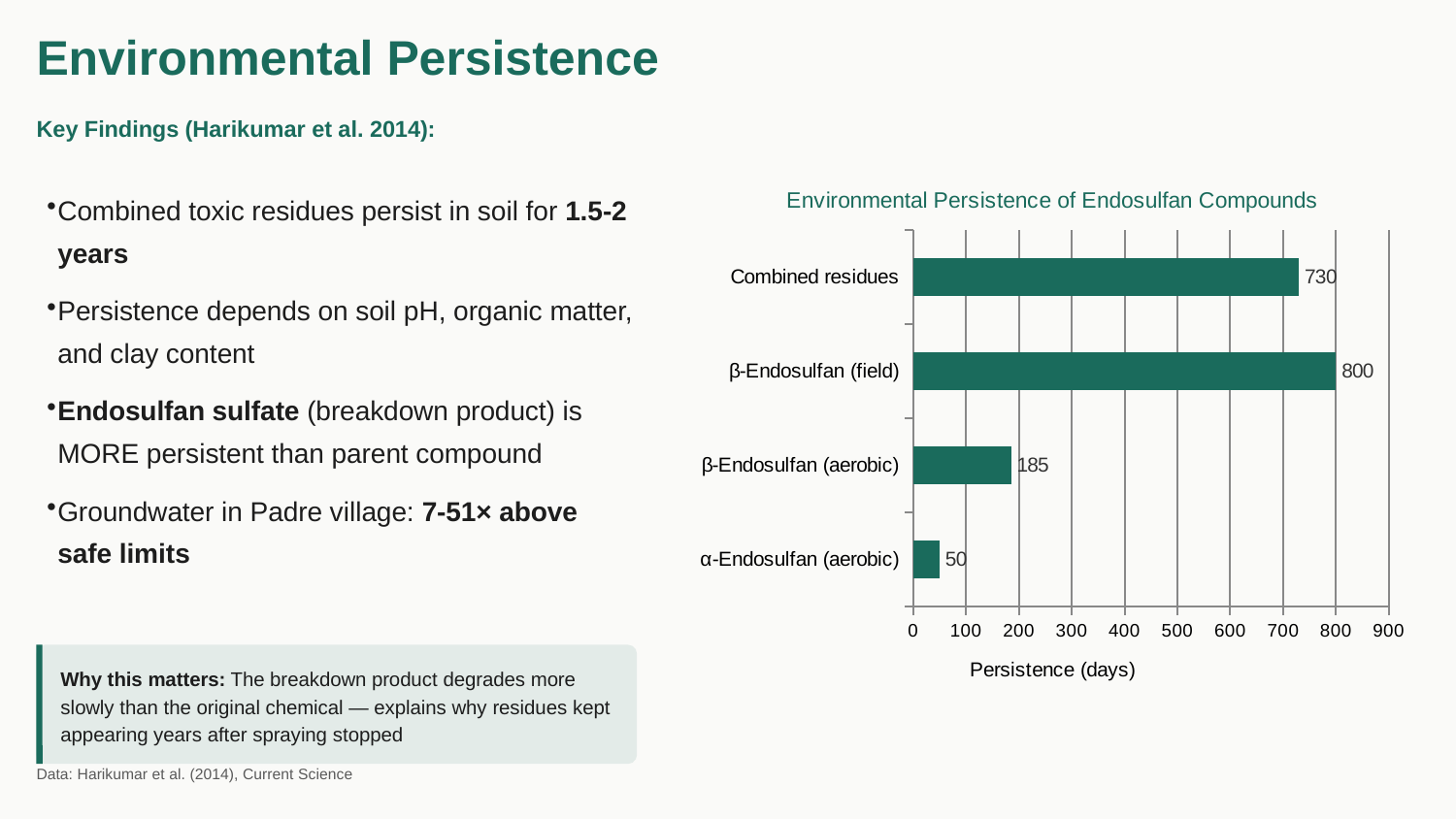
What is the persistence value for β-Endosulfan (aerobic)? 185 What is the persistence value for α-Endosulfan (aerobic)? 50 What is the persistence value for β-Endosulfan (field)? 800 What is the difference in persistence between β-Endosulfan (field) and Combined residues? 70 What is the title of the chart? Environmental Persistence of Endosulfan Compounds What kind of chart is shown on the slide? Bar chart Which has a larger persistence value, Combined residues or β-Endosulfan (aerobic)? Combined residues How many categories are shown in the chart? 4 Which category has the highest persistence? β-Endosulfan (field) Which category has the lowest persistence? α-Endosulfan (aerobic) What is the persistence value for Combined residues? 730 What is the difference in persistence between β-Endosulfan (aerobic) and α-Endosulfan (aerobic)? 135